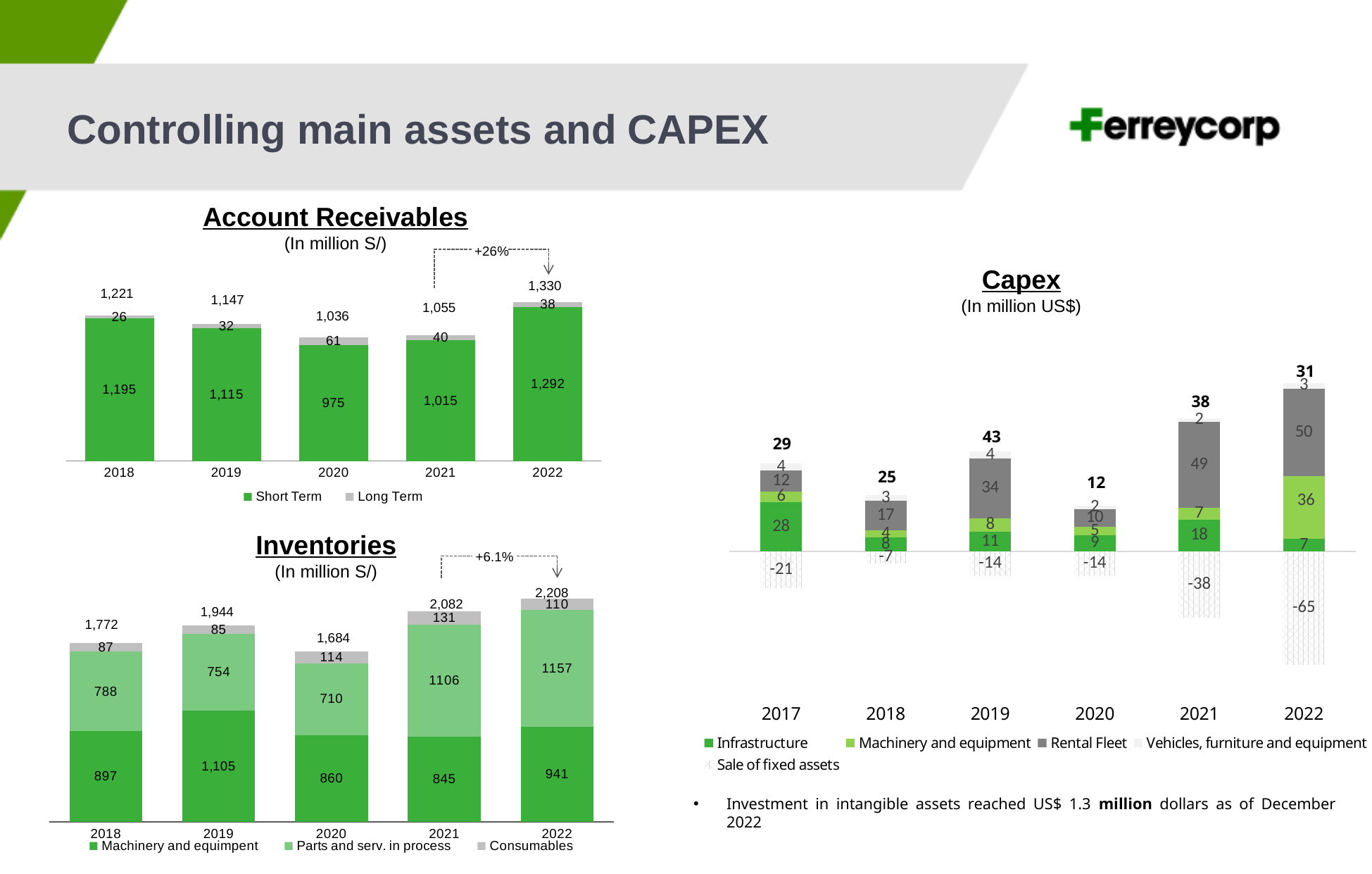
What kind of chart is the Capex chart? Stacked bar chart In the Inventories chart, how many series does the legend list? 3 In the Account Receivables chart, which year has the lowest total? 2020 In the Account Receivables chart, what is the Short Term value for 2022? 1,292 In the Capex chart, which year has the highest total Capex? 2019 In the Account Receivables chart, what percentage increase is annotated between 2021 and 2022? +26% In the Inventories chart, what is the Parts and serv. in process value for 2021? 1106 In the Capex chart, what is the Rental Fleet value for 2021? 49 In the Inventories chart, which year has the highest total? 2022 In the Capex chart, what is the Sale of fixed assets value for 2022? -65 In the Inventories chart, is the Machinery and equipment value larger in 2019 or 2020? 2019 In the Account Receivables chart, what is the difference between the Long Term values for 2020 and 2018? 35